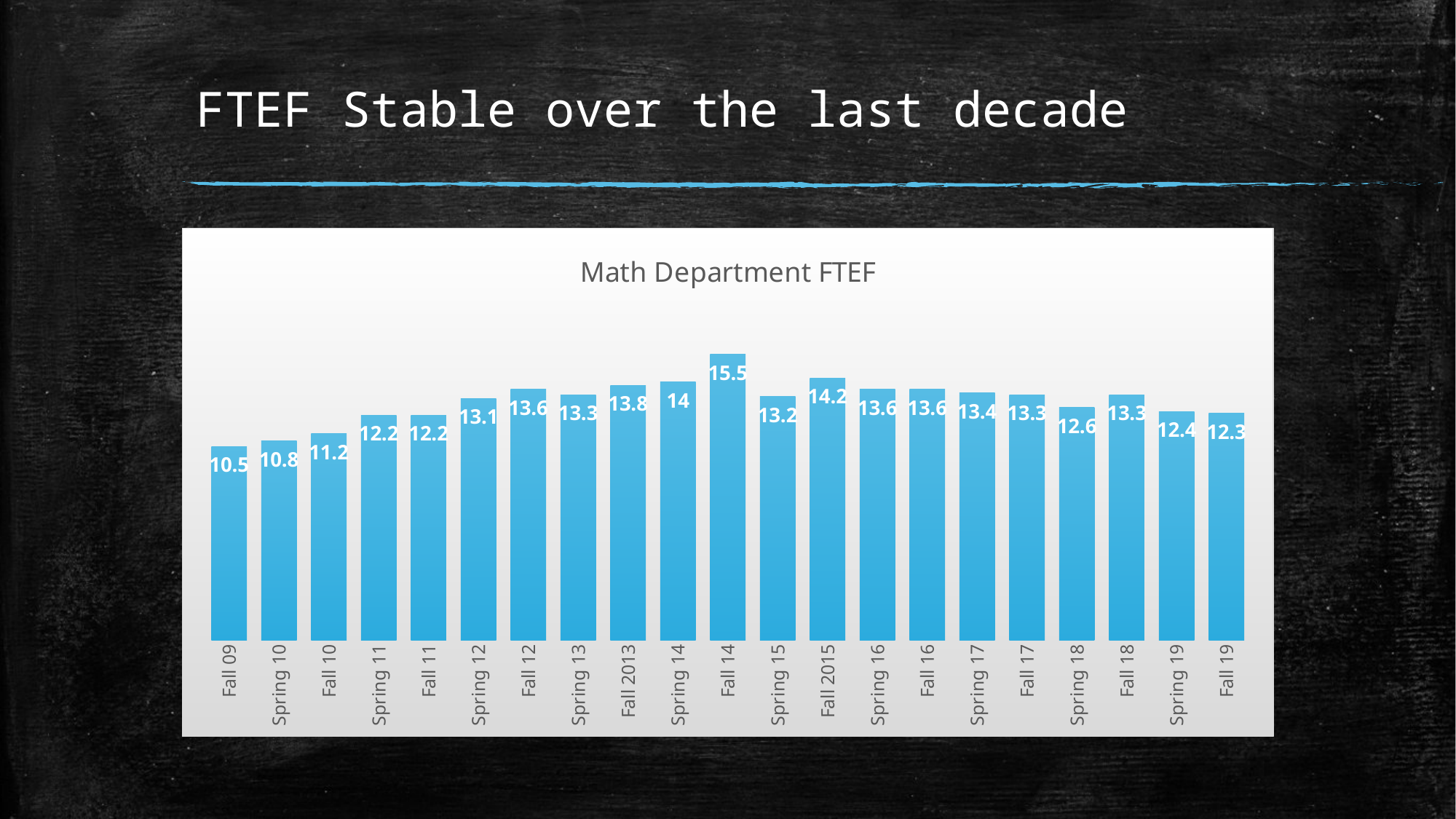
What is the FTEF value shown for Spring 18? 12.6 What is the Math Department FTEF value for Fall 14? 15.5 How many terms (bars) are plotted in the Math Department FTEF chart? 21 Which term has the lowest Math Department FTEF? Fall 09 Which is larger, the FTEF for Spring 14 or the FTEF for Spring 15? Spring 14 What is the title of the chart on the slide? Math Department FTEF What is the difference between the FTEF for Fall 14 and Fall 19? 3.2 Which term has the highest Math Department FTEF? Fall 14 What kind of chart is used to show the Math Department FTEF? Bar chart What is the difference between the FTEF for Fall 2013 and Fall 09? 3.3 What is the FTEF value shown for Fall 09? 10.5 What is the FTEF value shown for Fall 2015? 14.2